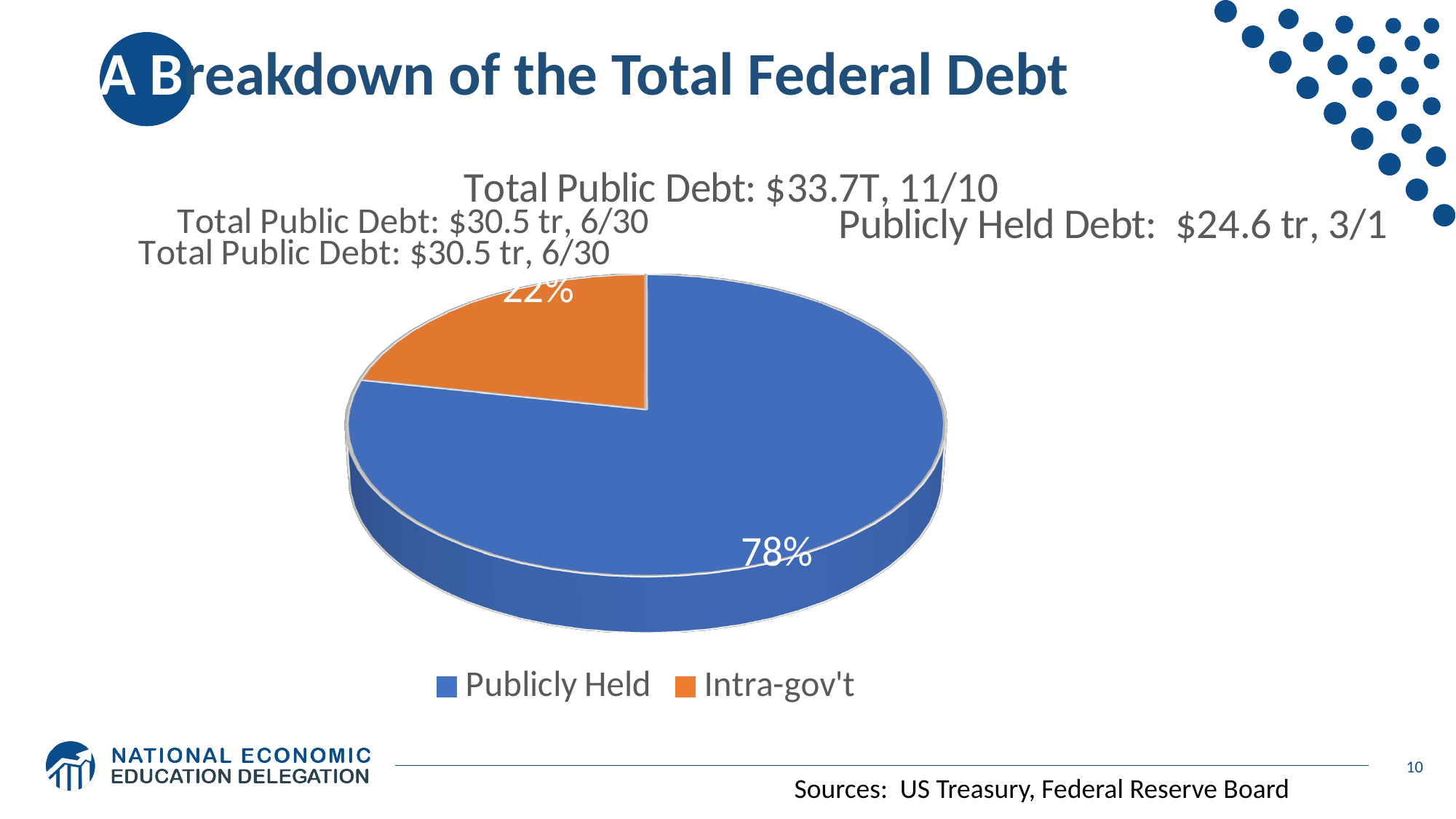
How many slices does the pie chart have? 2 What colour is the Intra-gov't slice? orange What share of the pie does the Intra-gov't slice represent? 22% What kind of chart is shown on the slide? pie chart How many entries does the legend list? 2 Which slice of the pie is the largest? Publicly Held What is the difference in percentage points between the Publicly Held and Intra-gov't slices? 56 Which slice of the pie is the smallest? Intra-gov't What is the title of the slide containing the pie chart? A Breakdown of the Total Federal Debt What share of the pie does the Publicly Held slice represent? 78% Which is larger, the Publicly Held slice or the Intra-gov't slice? Publicly Held